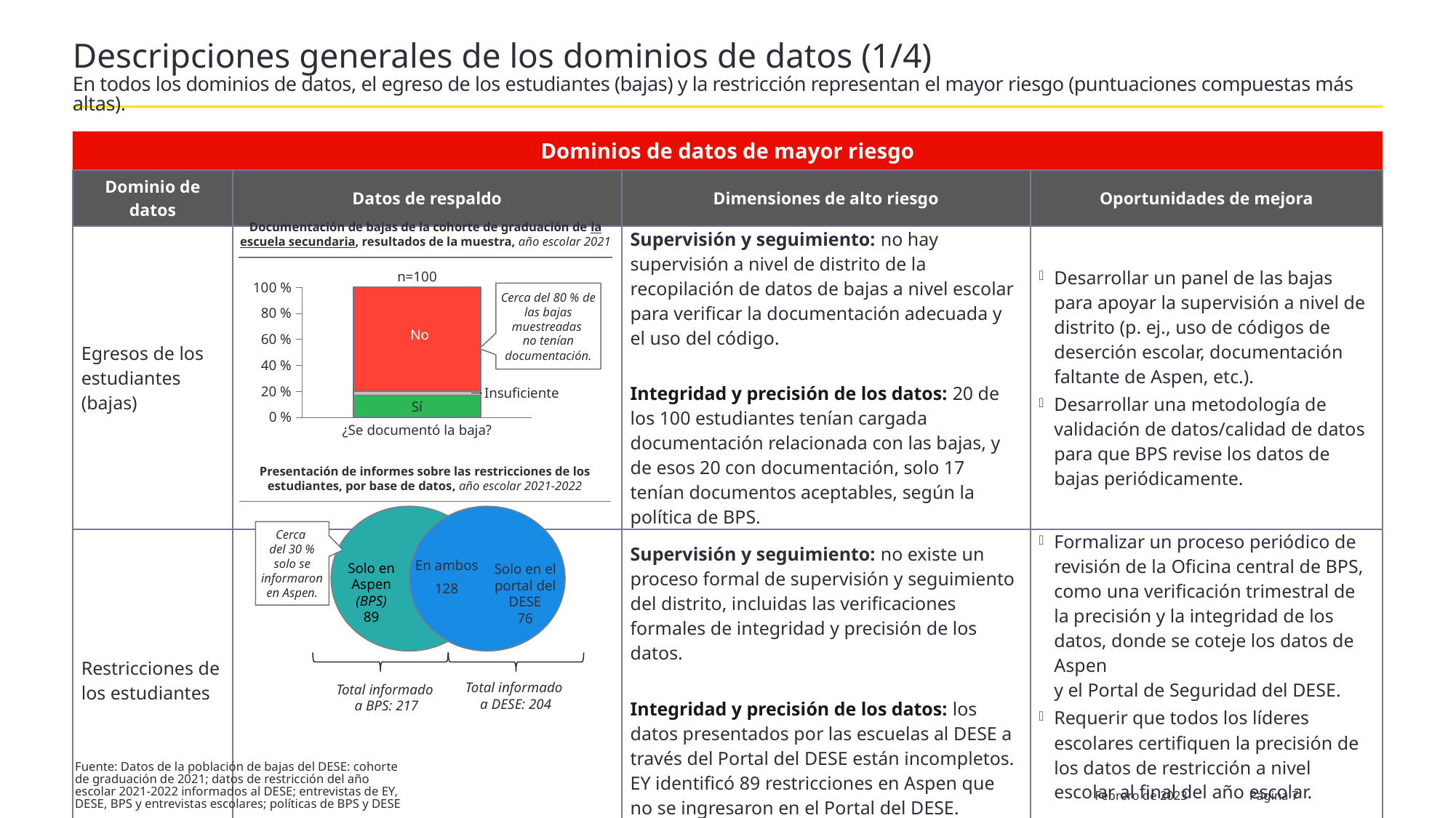
In the 'Documentación de bajas' bar chart, what sample size (n) is shown above the bar? n=100 In the 'Documentación de bajas' bar chart, what is the label under the x axis? ¿Se documentó la baja? In the 'Documentación de bajas' bar chart, how many segments make up the stacked bar? 3 In the 'Documentación de bajas' bar chart, which segment is the smallest? Insuficiente In the 'Presentación de informes sobre las restricciones de los estudiantes' diagram, which is larger: 'Solo en Aspen (BPS)' or 'Solo en el portal del DESE'? Solo en Aspen (BPS) In the 'Documentación de bajas' bar chart, which segment is the largest? No In the 'Presentación de informes sobre las restricciones de los estudiantes' diagram, how many restrictions were reported only in the DESE portal? 76 In the 'Presentación de informes sobre las restricciones de los estudiantes' diagram, how many restrictions were reported only in Aspen (BPS)? 89 In the 'Presentación de informes sobre las restricciones de los estudiantes' diagram, how many restrictions were reported in both databases ('En ambos')? 128 In the 'Presentación de informes sobre las restricciones de los estudiantes' diagram, what is the total reported to BPS? 217 What kind of chart is used in the 'Documentación de bajas de la cohorte de graduación de la escuela secundaria' chart? bar chart In the 'Documentación de bajas' bar chart, is the 'Sí' segment greater or less than 20 %? less